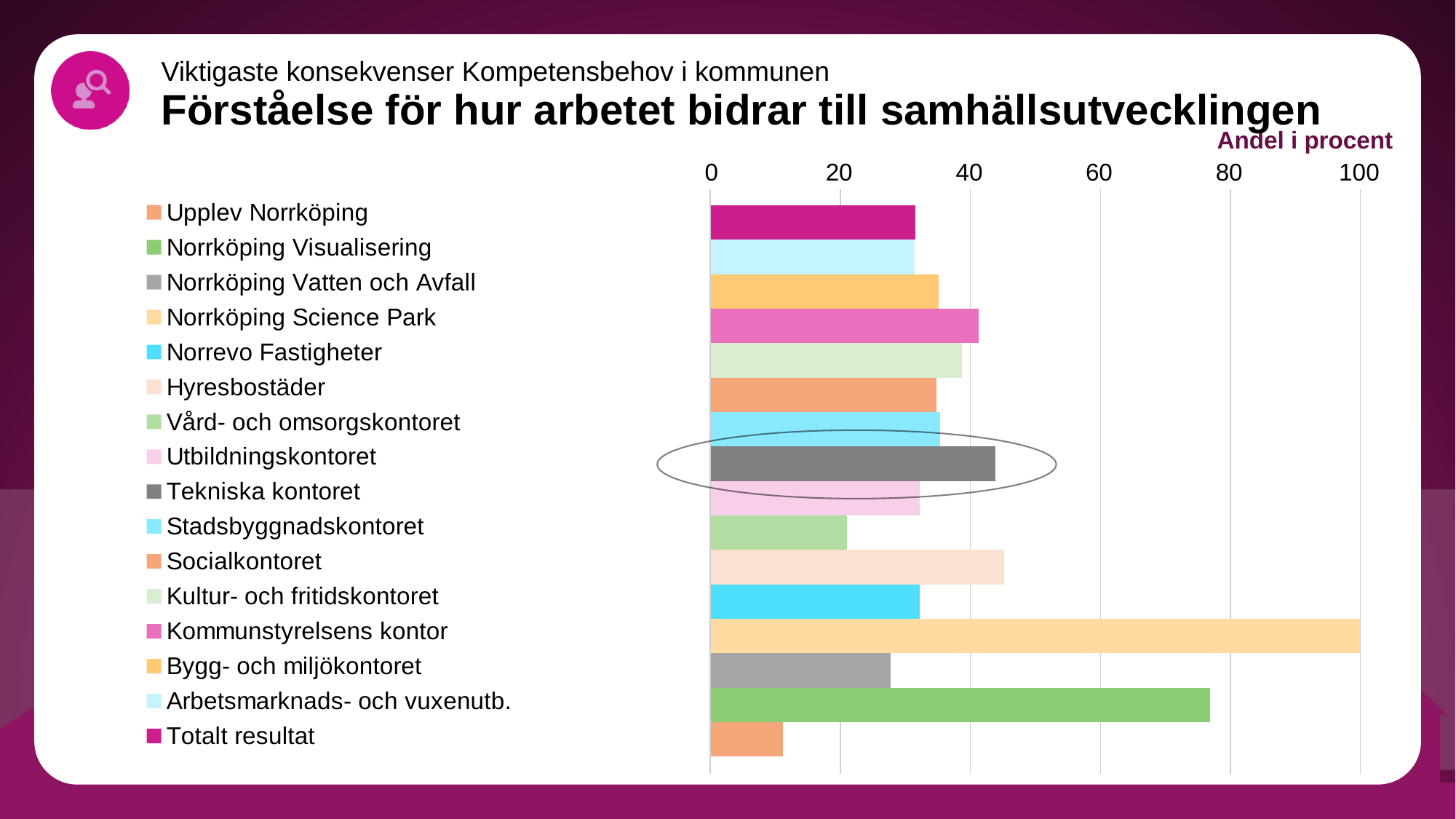
Is the value for Upplev Norrköping greater or less than 20? less Which is larger, the value for Norrköping Visualisering or the value for Hyresbostäder? Norrköping Visualisering Which is larger, the value for Hyresbostäder or the value for Vård- och omsorgskontoret? Hyresbostäder How many series does the legend list? 16 What unit label is shown above the chart's axis? Andel i procent What is the value for Norrköping Science Park? 100 Which category has the lowest value? Upplev Norrköping What kind of chart is shown on the slide? bar chart Which category has the highest value? Norrköping Science Park How many bars are plotted in the chart? 16 Is the value for Norrköping Vatten och Avfall greater or less than 40? less Is the value for Norrköping Visualisering greater or less than 60? greater